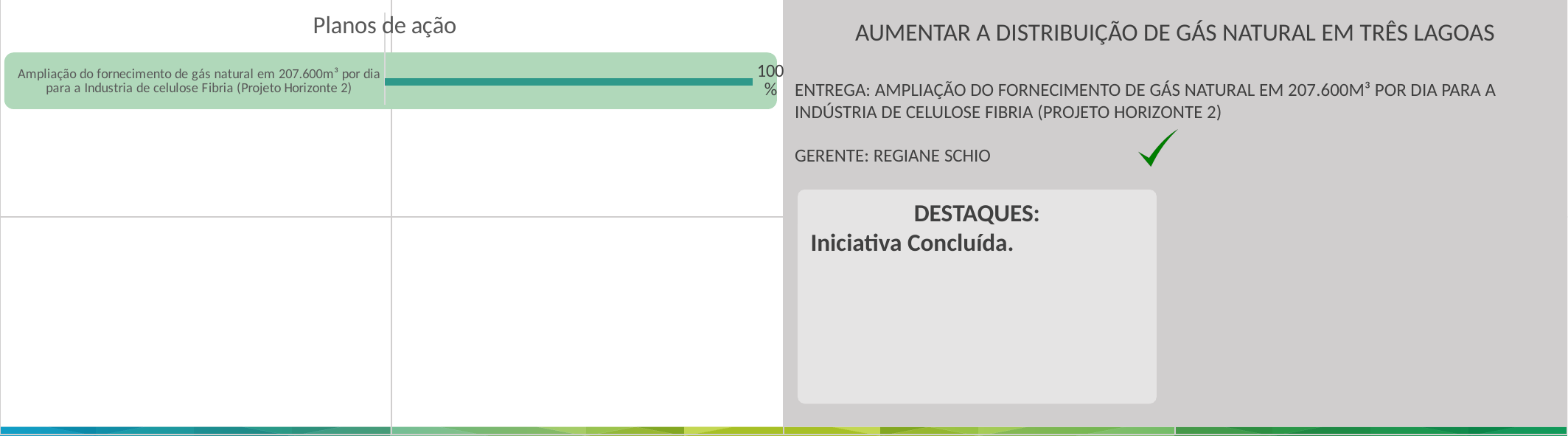
Which category has the highest value in the Planos de ação chart? Ampliação do fornecimento de gás natural em 207.600m³ por dia para a Industria de celulose Fibria (Projeto Horizonte 2) What kind of chart is the Planos de ação chart? Bar chart What is the label of the only category in the Planos de ação chart? Ampliação do fornecimento de gás natural em 207.600m³ por dia para a Industria de celulose Fibria (Projeto Horizonte 2) How many categories are plotted in the Planos de ação chart? 1 What is the title of the chart on the slide? Planos de ação What is the value shown for "Ampliação do fornecimento de gás natural em 207.600m³ por dia para a Industria de celulose Fibria (Projeto Horizonte 2)" in the Planos de ação chart? 100%